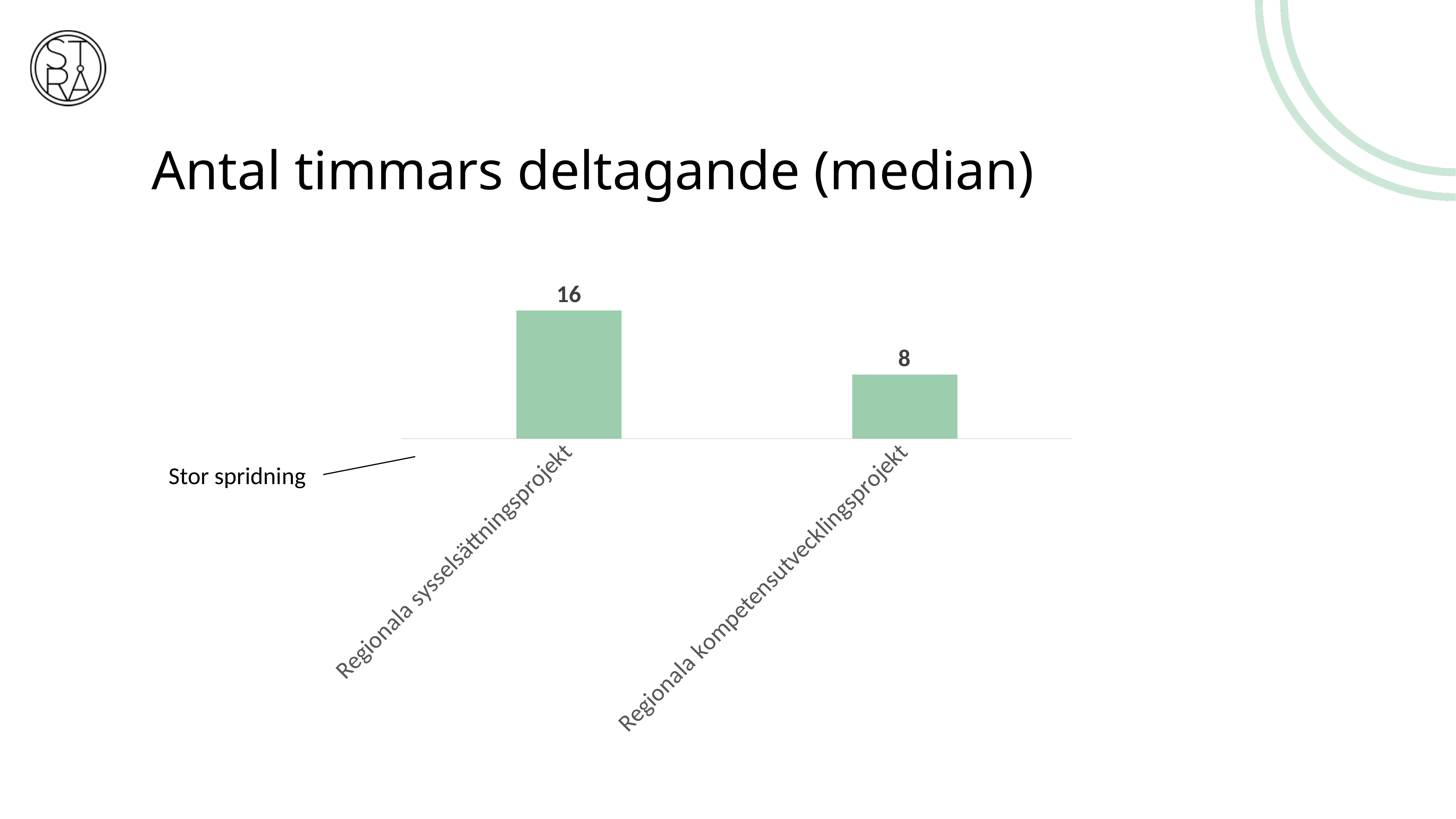
What does the annotation text to the left of the chart say? Stor spridning What is the value for Regionala sysselsättningsprojekt? 16 Do the values rise or fall from left to right along the x axis? fall Which is larger, the value for Regionala sysselsättningsprojekt or the value for Regionala kompetensutvecklingsprojekt? Regionala sysselsättningsprojekt Which category has the highest value? Regionala sysselsättningsprojekt What kind of chart is shown on the slide? bar chart How many categories are shown in the chart? 2 What is the value for Regionala kompetensutvecklingsprojekt? 8 Which category has the lowest value? Regionala kompetensutvecklingsprojekt What is the title of the slide above the chart? Antal timmars deltagande (median) What is the difference between the values for Regionala sysselsättningsprojekt and Regionala kompetensutvecklingsprojekt? 8